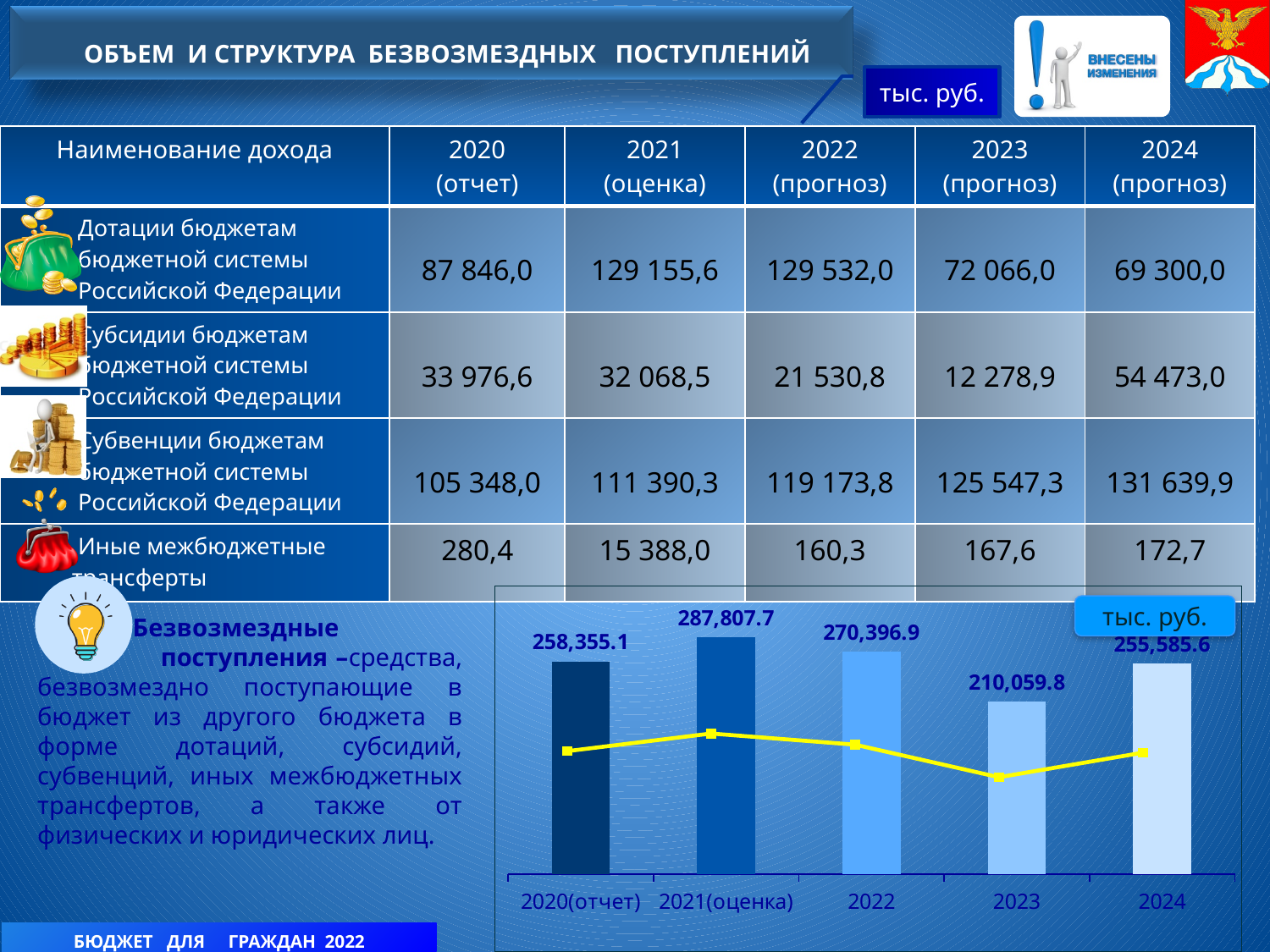
What is the difference between the values for 2021(оценка) and 2020(отчет) in the bar chart? 29,452.6 Do the values in the bar chart rise or fall from 2021(оценка) to 2023? fall What is the value shown for 2021(оценка) in the bar chart? 287,807.7 What is the value shown for 2024 in the bar chart? 255,585.6 What kind of chart is shown at the bottom of the slide? bar chart with a line How many bars are plotted in the bar chart? 5 Which year has the lowest value in the bar chart? 2023 In the bar chart, which is larger: the value for 2022 or the value for 2024? 2022 What is the value shown for 2023 in the bar chart? 210,059.8 What is the difference between the values for 2022 and 2023 in the bar chart? 60,337.1 Which year has the highest value in the bar chart? 2021(оценка) What is the value shown for 2020(отчет) in the bar chart? 258,355.1